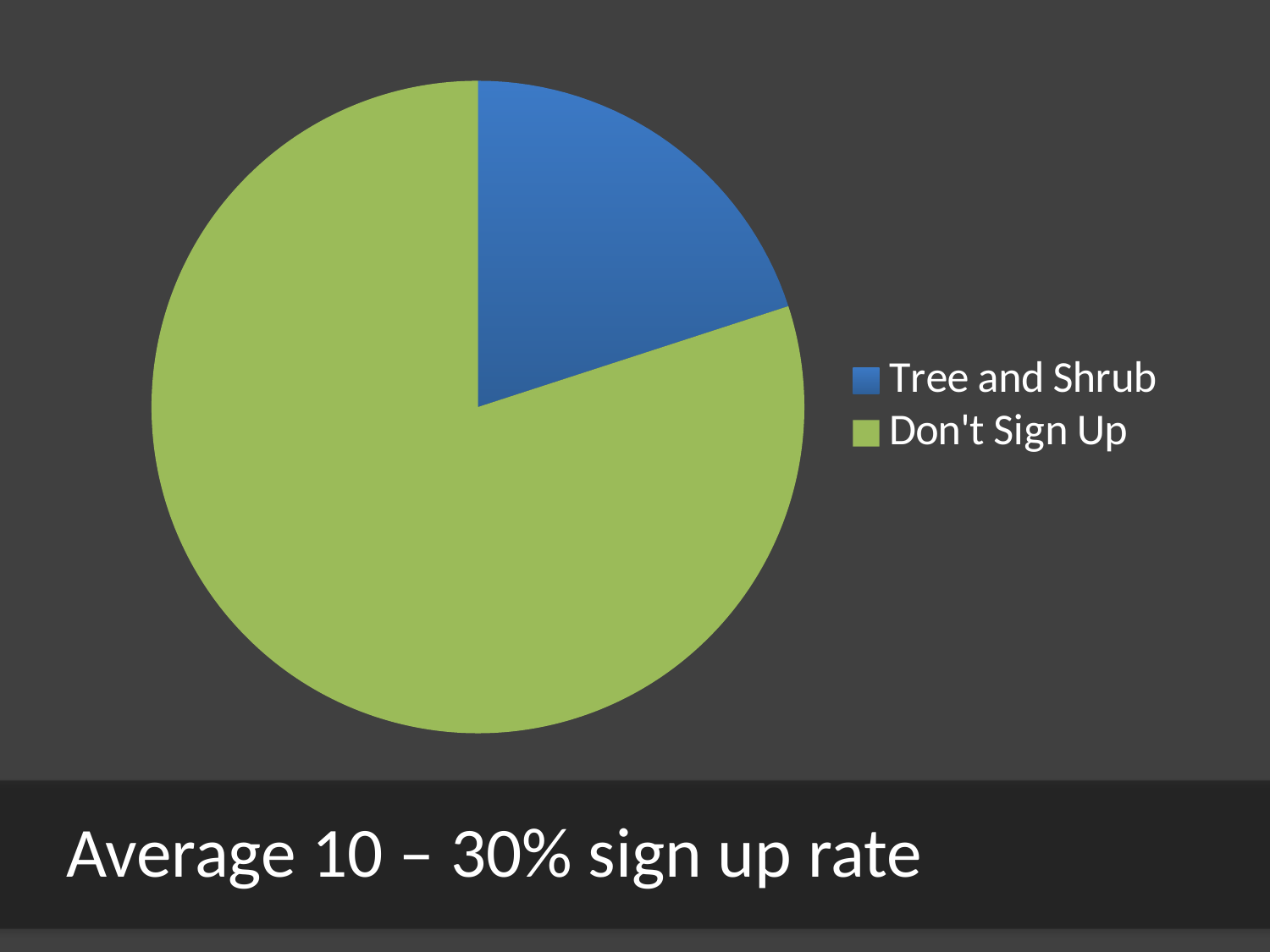
Which slice of the pie chart is the largest? Don't Sign Up Which colour represents Tree and Shrub in the pie chart? blue What kind of chart is shown on the slide? pie chart How many entries does the legend of the pie chart list? 2 How many slices does the pie chart have? 2 Which legend entry is shown in green in the pie chart? Don't Sign Up Which is larger in the pie chart, Tree and Shrub or Don't Sign Up? Don't Sign Up Which slice of the pie chart is the smallest? Tree and Shrub